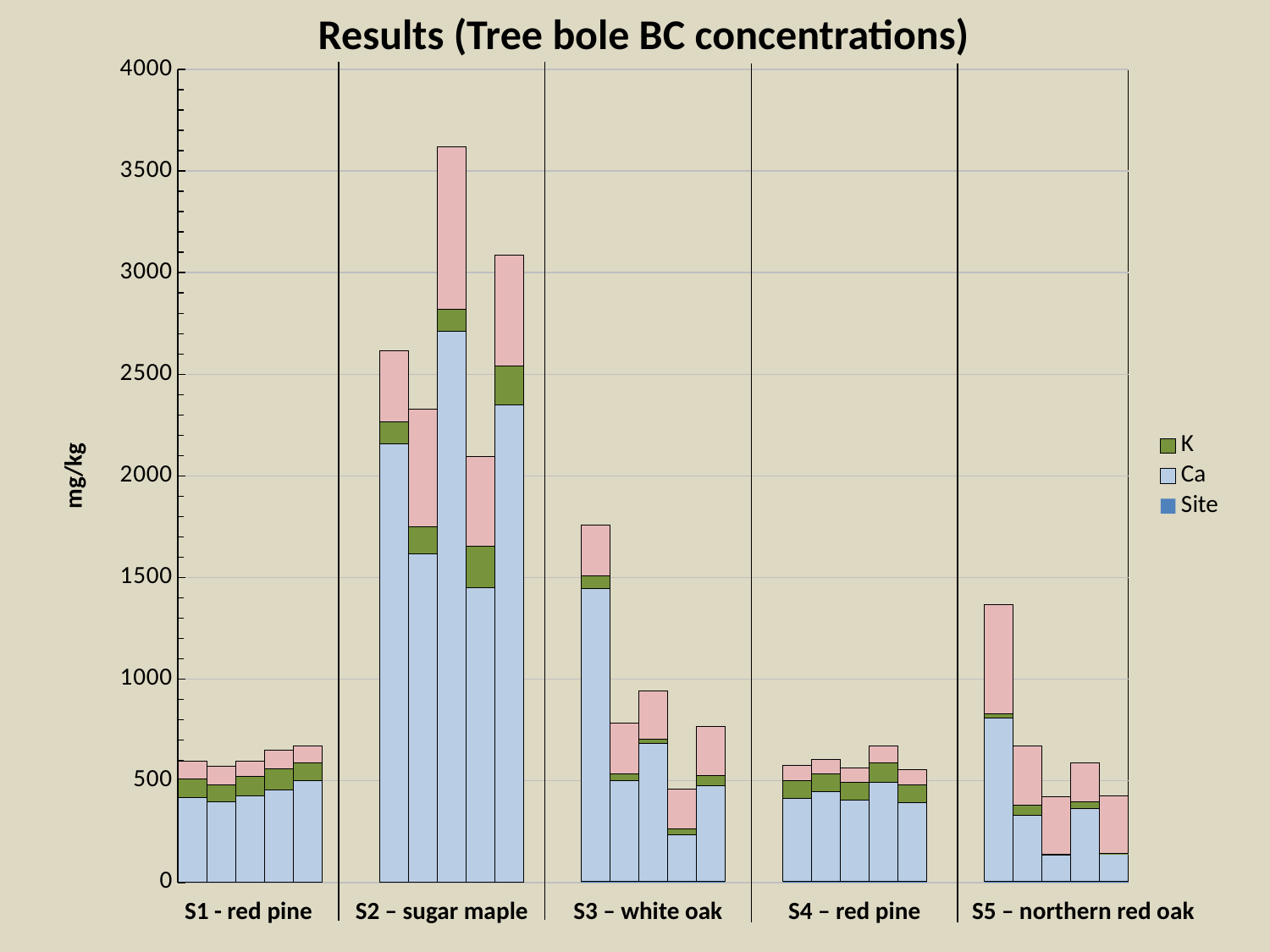
Is the tallest bar in the S5 – northern red oak group greater or less than 1000 mg/kg? greater How many bars are plotted in the S2 – sugar maple group? 5 What is the label on the y axis? mg/kg Which group has the taller tallest bar, S3 – white oak or S5 – northern red oak? S3 – white oak What kind of chart is shown on the slide? Stacked bar chart How many site groups are shown along the x axis? 5 Are all the bars in the S4 – red pine group greater or less than 1000 mg/kg? less Is the tallest bar in the S2 – sugar maple group greater or less than 3500 mg/kg? greater How many series does the legend list? 3 Which site group contains the tallest bar in the chart? S2 – sugar maple What is the title of the chart? Results (Tree bole BC concentrations)